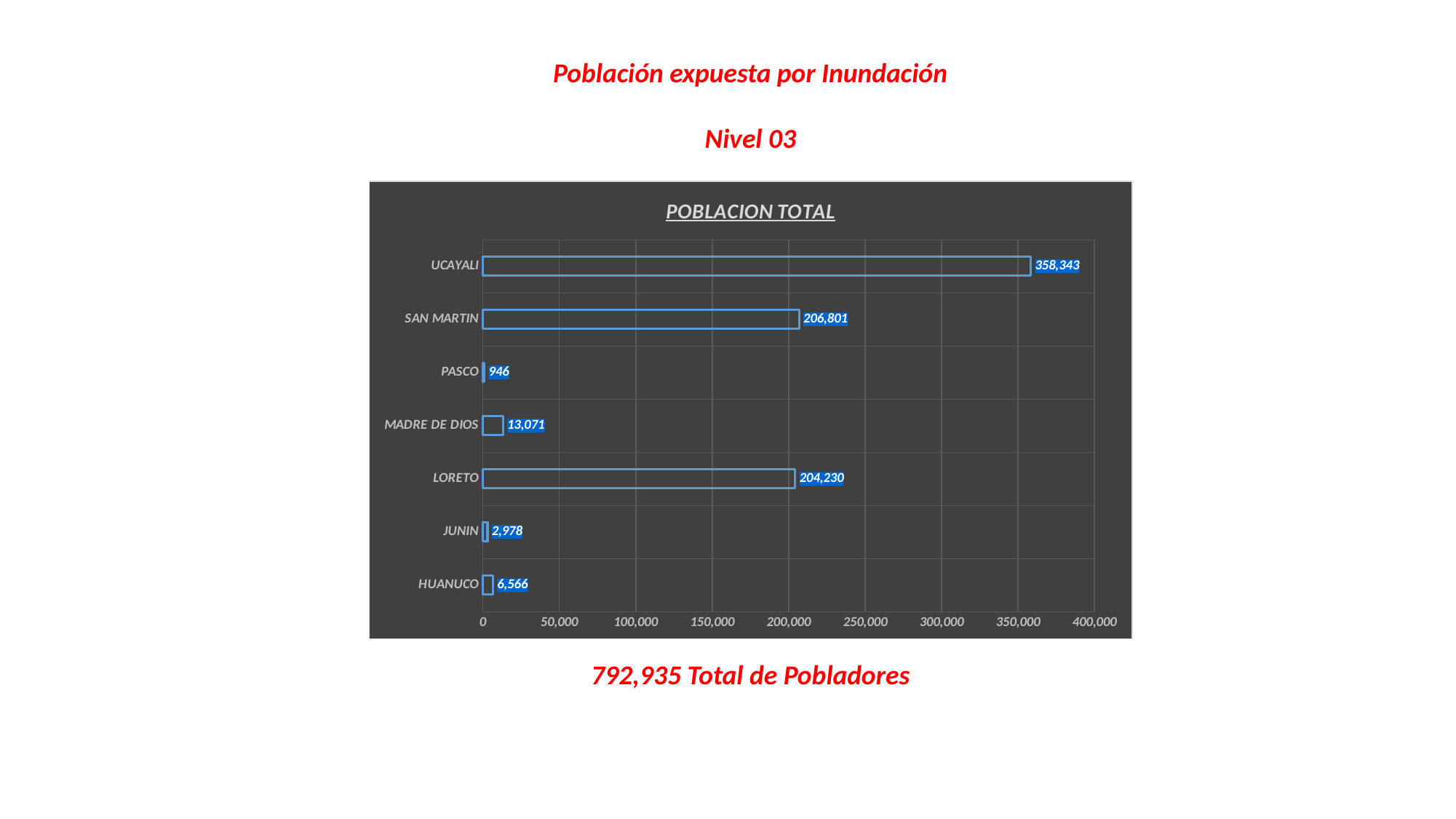
What is the difference between the values for SAN MARTIN and LORETO? 2,571 Which category has the lowest value? PASCO What is the difference between the values for UCAYALI and SAN MARTIN? 151,542 What is the value for MADRE DE DIOS? 13,071 Is the value for UCAYALI greater or less than 350,000? greater Which is larger, the value for JUNIN or the value for HUANUCO? HUANUCO How many categories are shown in the chart? 7 What is the value for HUANUCO? 6,566 What is the value for UCAYALI? 358,343 What kind of chart is shown? bar chart What is the title of the chart? POBLACION TOTAL Which category has the highest value? UCAYALI